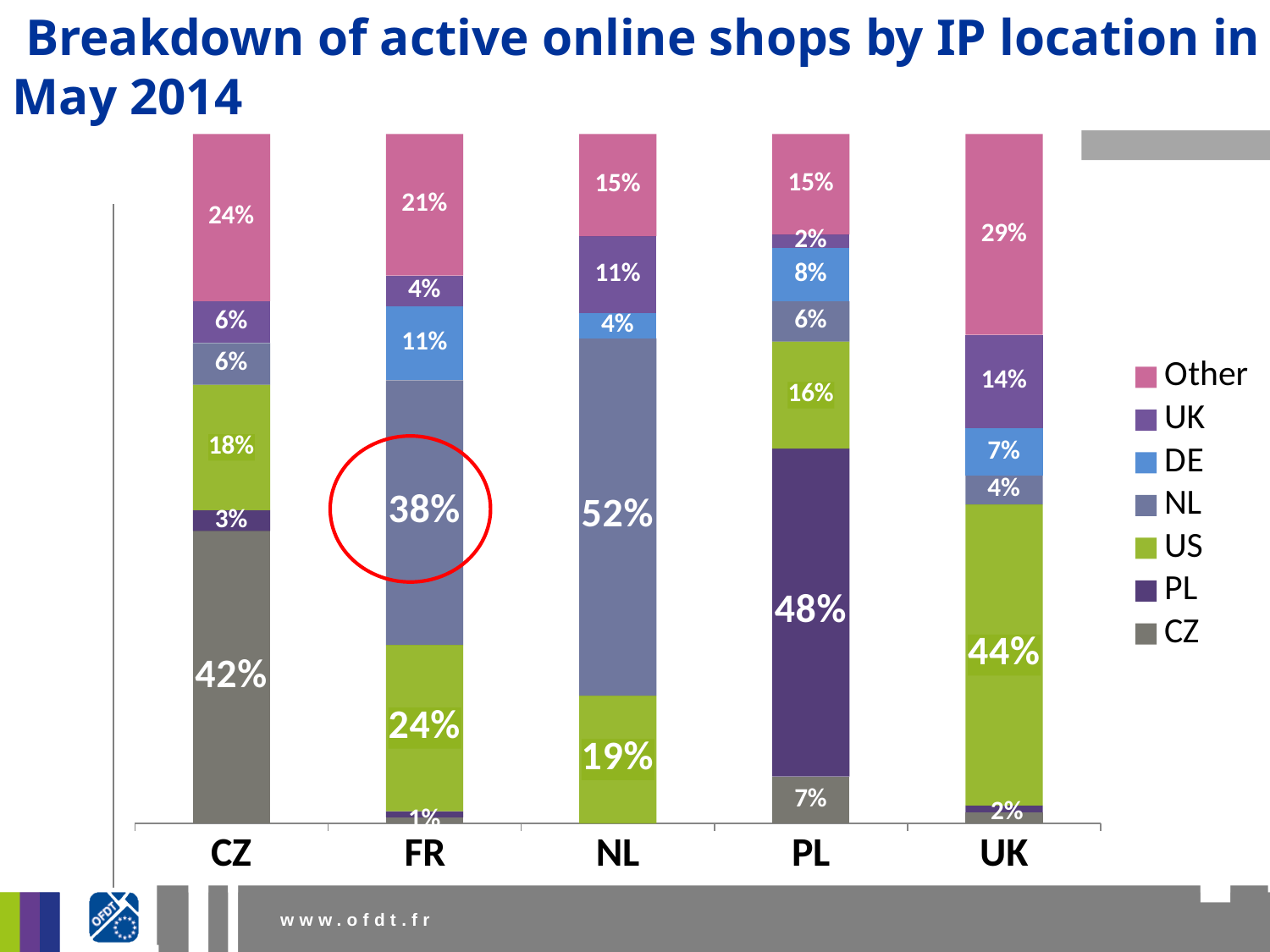
How many countries are shown along the x axis of the chart? 5 What is the US share in the UK bar? 44% In the NL bar, what percentage is attributed to NL IP location? 52% In the PL bar, what percentage is attributed to PL IP location? 48% Which country's bar has the highest 'Other' share? UK Which bar has the larger 'Other' share, CZ or FR? CZ What is the 'Other' share in the UK bar? 29% What is the CZ share in the CZ bar? 42% What share of active online shops in the FR bar is attributed to NL IP location? 38% What kind of chart is shown on the slide? Stacked bar chart How many series does the legend list? 7 What is the difference between the US share in the UK bar and the US share in the FR bar? 20 percentage points